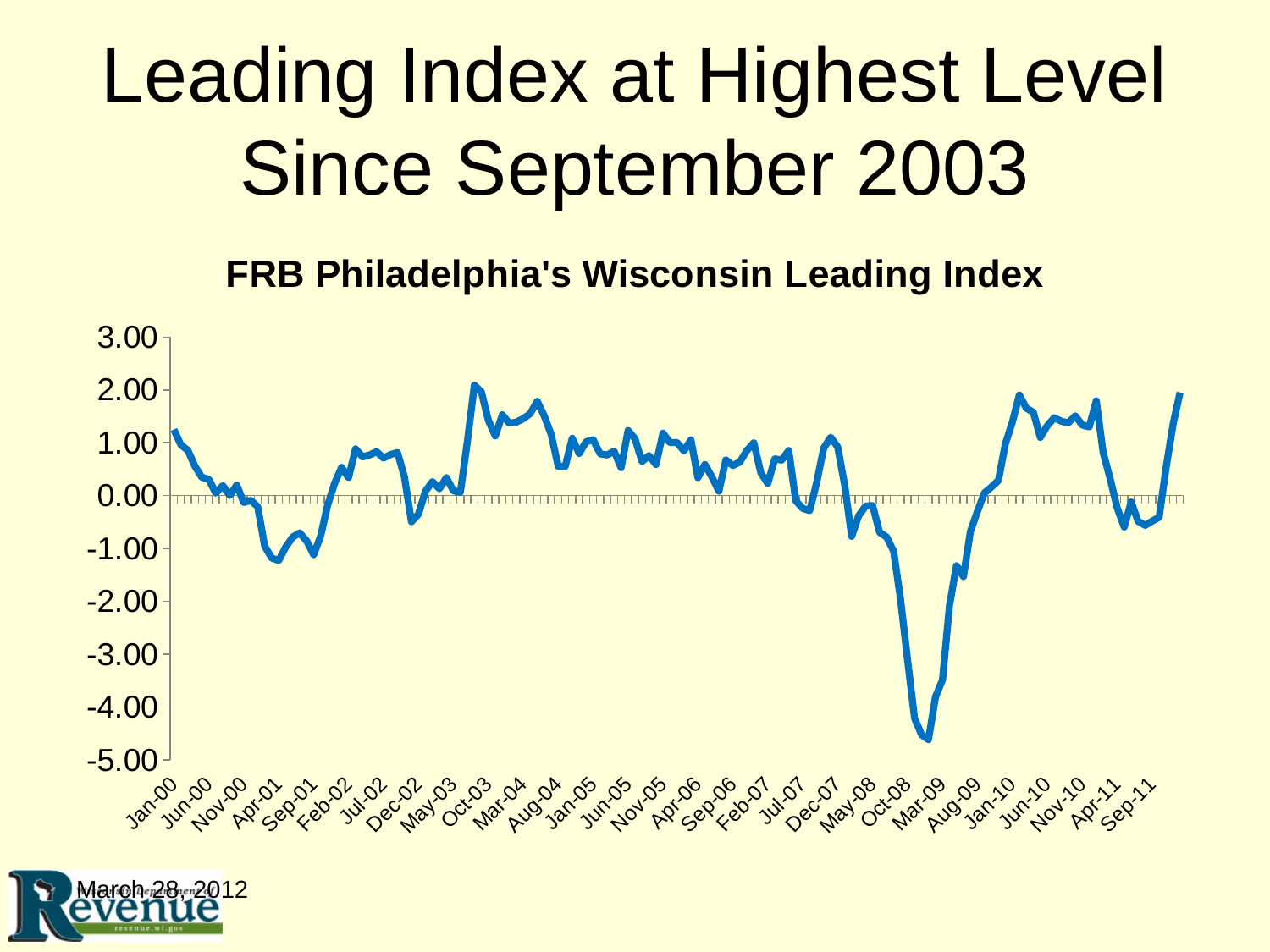
Does the line rise or fall between Oct-08 and Mar-09? fall What colour is the line plotted on the chart? blue What kind of chart is shown on the slide? line chart Around which labeled date does the line reach its lowest value? Mar-09 Is the value for Oct-08 greater or less than 0.00? less Is the value for Mar-09 greater or less than -3.00? less Is the value for Jan-00 greater or less than 0.00? greater How many lines are plotted on the chart? 1 What is the title of the chart? FRB Philadelphia's Wisconsin Leading Index